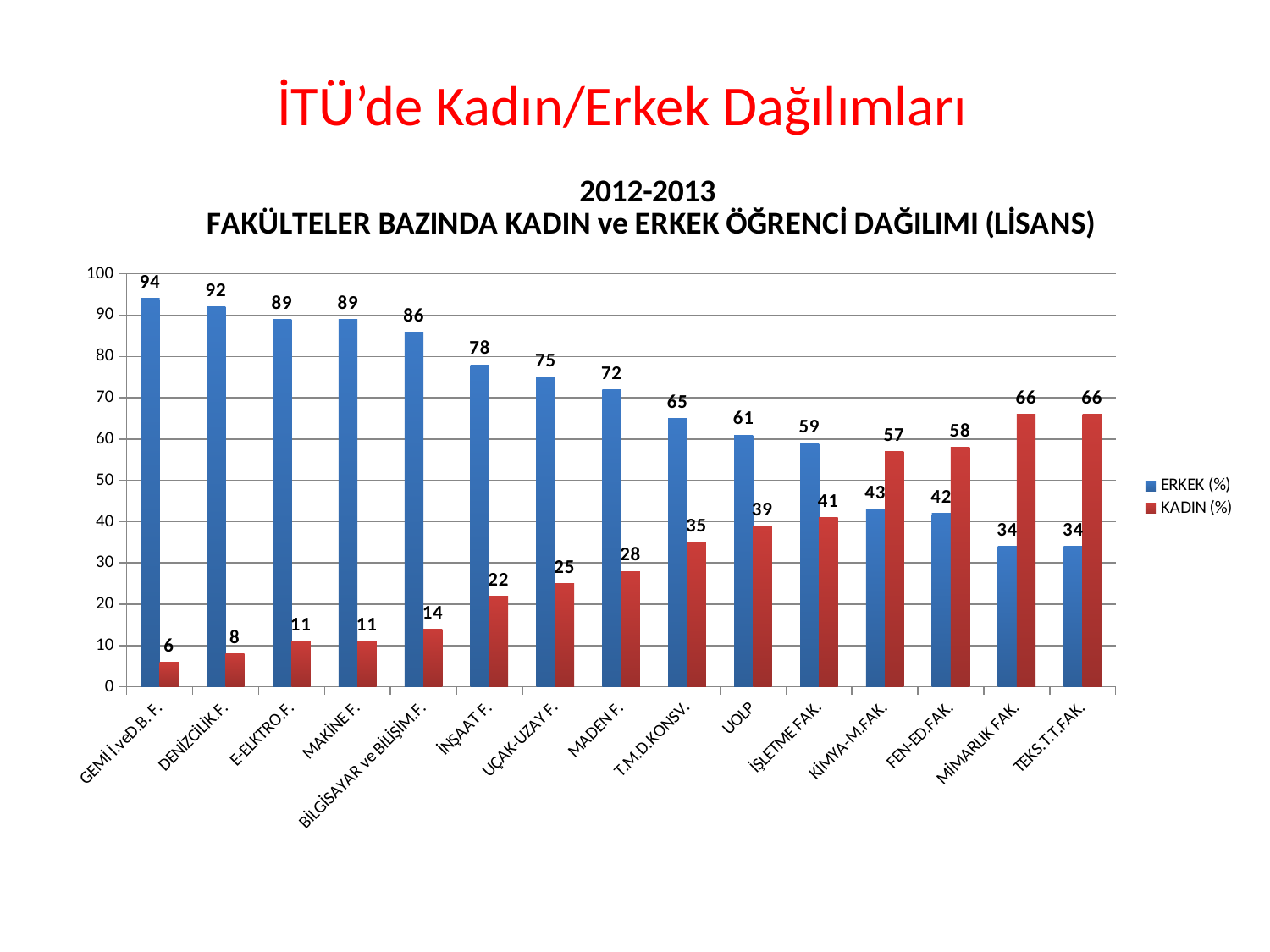
What is the ERKEK (%) value for MADEN F.? 72 Which is larger for FEN-ED.FAK., the ERKEK (%) value or the KADIN (%) value? KADIN (%) How many series does the legend list? 2 What kind of chart is shown on the slide? Bar chart Do the ERKEK (%) values rise or fall from left to right along the x axis? Fall Which faculty has the highest ERKEK (%) value? GEMİ İ.veD.B. F. Is the ERKEK (%) value for İNŞAAT F. greater or less than 70? greater What is the KADIN (%) value for BİLGİSAYAR ve BİLİŞİM.F.? 14 How many faculties are shown on the x axis? 15 What is the KADIN (%) value for İŞLETME FAK.? 41 What is the difference between the ERKEK (%) and KADIN (%) values for UOLP? 22 Which faculty has the lowest KADIN (%) value? GEMİ İ.veD.B. F.